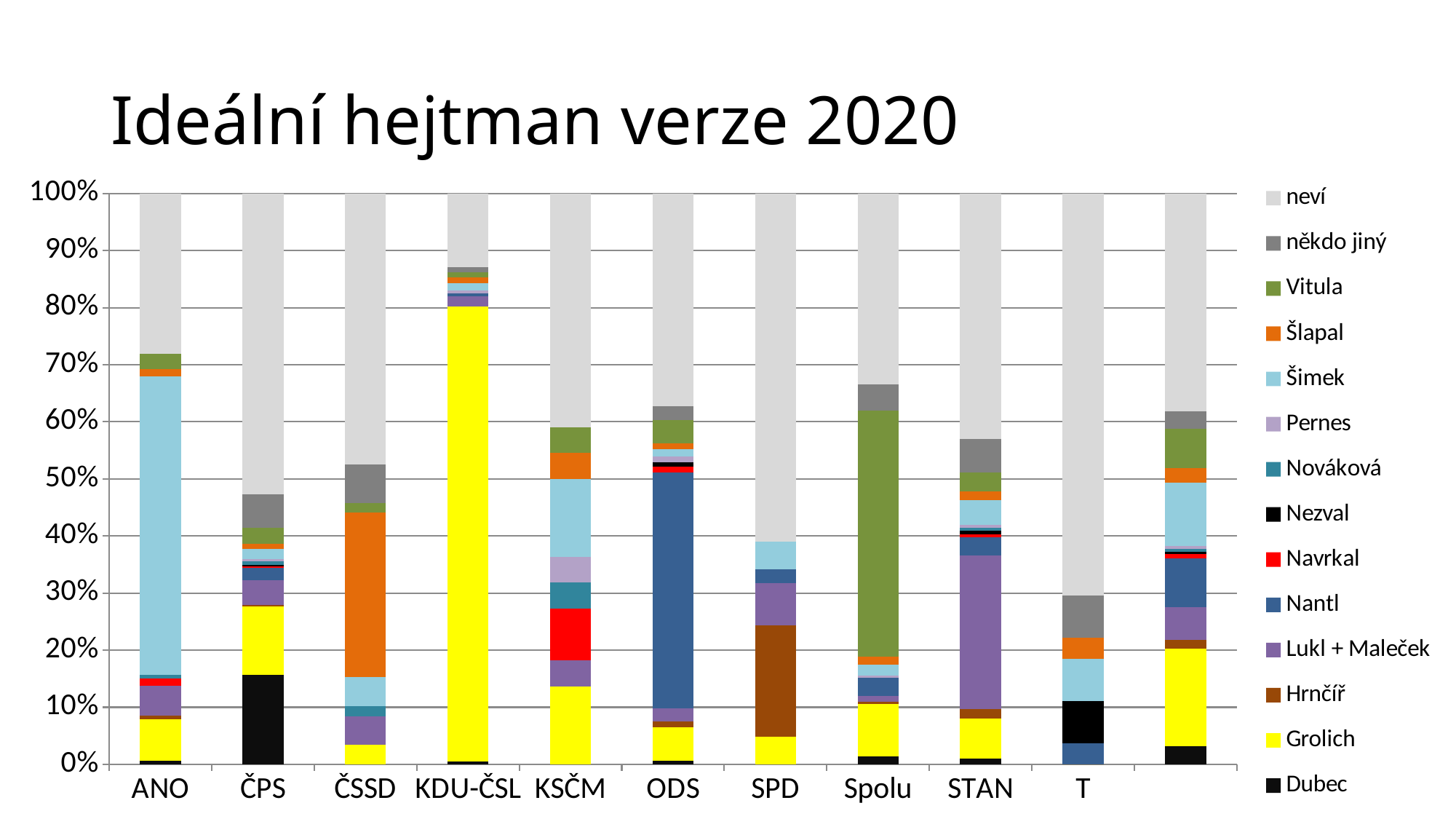
Is the Grolich segment for KDU-ČSL greater or less than 70%? greater What kind of chart is shown on the slide? stacked bar chart What is the title of the chart? Ideální hejtman verze 2020 Is the Lukl + Maleček segment for STAN greater or less than 20%? greater Which has the larger Grolich segment, KDU-ČSL or ČPS? KDU-ČSL Is the Nezval segment for T greater or less than 10%? less Which bar has the smallest 'neví' segment? KDU-ČSL How many bars are plotted in the chart? 11 Which bar has the largest 'neví' segment? T How many series does the legend list? 14